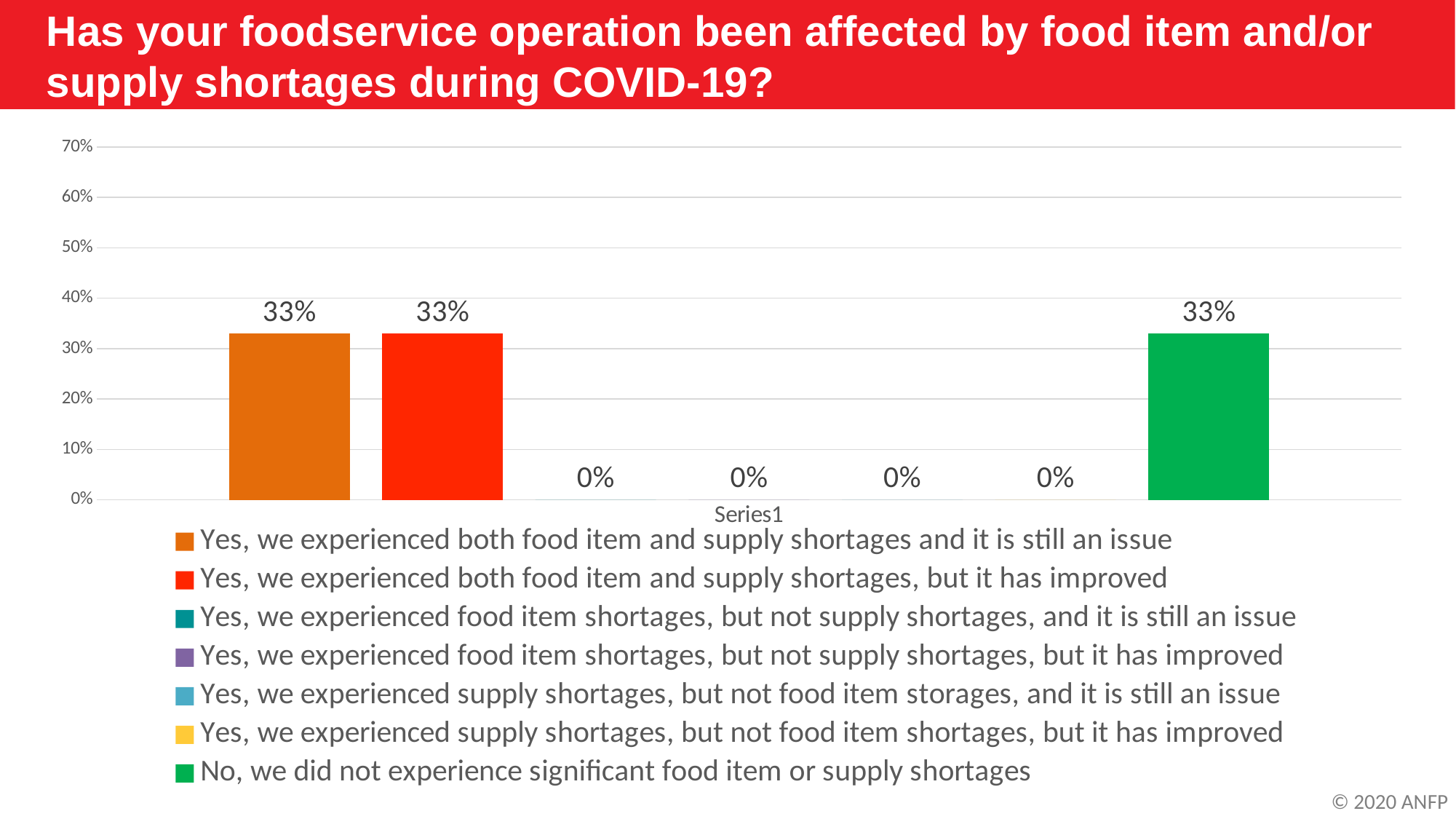
What percentage of respondents said they did not experience significant food item or supply shortages? 33% What percentage of respondents said they experienced food item shortages, but not supply shortages, and it is still an issue? 0% Which is larger: the value for 'Yes, we experienced both food item and supply shortages, but it has improved' or the value for 'Yes, we experienced supply shortages, but not food item storages, and it is still an issue'? Yes, we experienced both food item and supply shortages, but it has improved What kind of chart is shown on the slide? bar chart What percentage of respondents said they experienced both food item and supply shortages, but it has improved? 33% How many series does the legend list? 7 Is the value for 'No, we did not experience significant food item or supply shortages' greater or less than 40%? less How many of the plotted series have a value of 0%? 4 What colour is the bar for 'No, we did not experience significant food item or supply shortages'? green What percentage of respondents said they experienced supply shortages, but not food item shortages, but it has improved? 0% What is the difference between the value for 'No, we did not experience significant food item or supply shortages' and the value for 'Yes, we experienced food item shortages, but not supply shortages, but it has improved'? 33% What percentage of respondents said they experienced both food item and supply shortages and it is still an issue? 33%